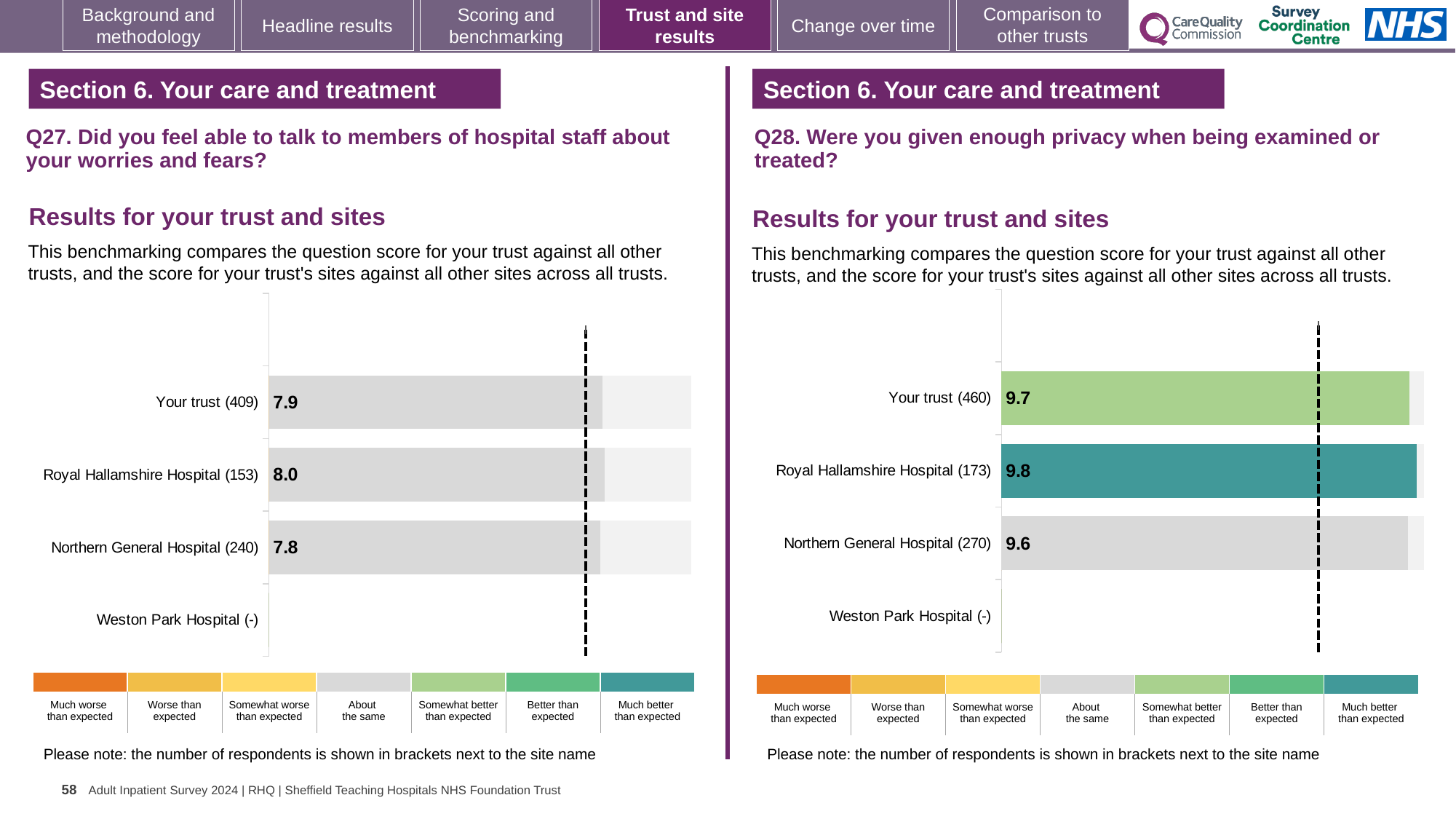
In the Q27 chart on the left, what is the score for Royal Hallamshire Hospital? 8.0 In the Q28 chart on the right, what is the score for Your trust? 9.7 In the Q27 chart on the left, which site has the lowest score? Northern General Hospital In the Q27 chart on the left, what is the difference between the scores for Royal Hallamshire Hospital and Northern General Hospital? 0.2 In the Q28 chart on the right, which is larger: the score for Your trust or the score for Northern General Hospital? Your trust In the Q27 chart on the left, what is the score for Your trust? 7.9 In the Q28 chart on the right, which site has the highest score? Royal Hallamshire Hospital In the Q28 chart on the right, how many respondents are shown in brackets for Royal Hallamshire Hospital? 173 In the Q28 chart on the right, what is the score for Northern General Hospital? 9.6 What kind of chart is used in the Q27 chart on the left? Bar chart In the Q27 chart on the left, what is the score for Northern General Hospital? 7.8 In the Q27 chart on the left, how many site rows are listed on the vertical axis? 4